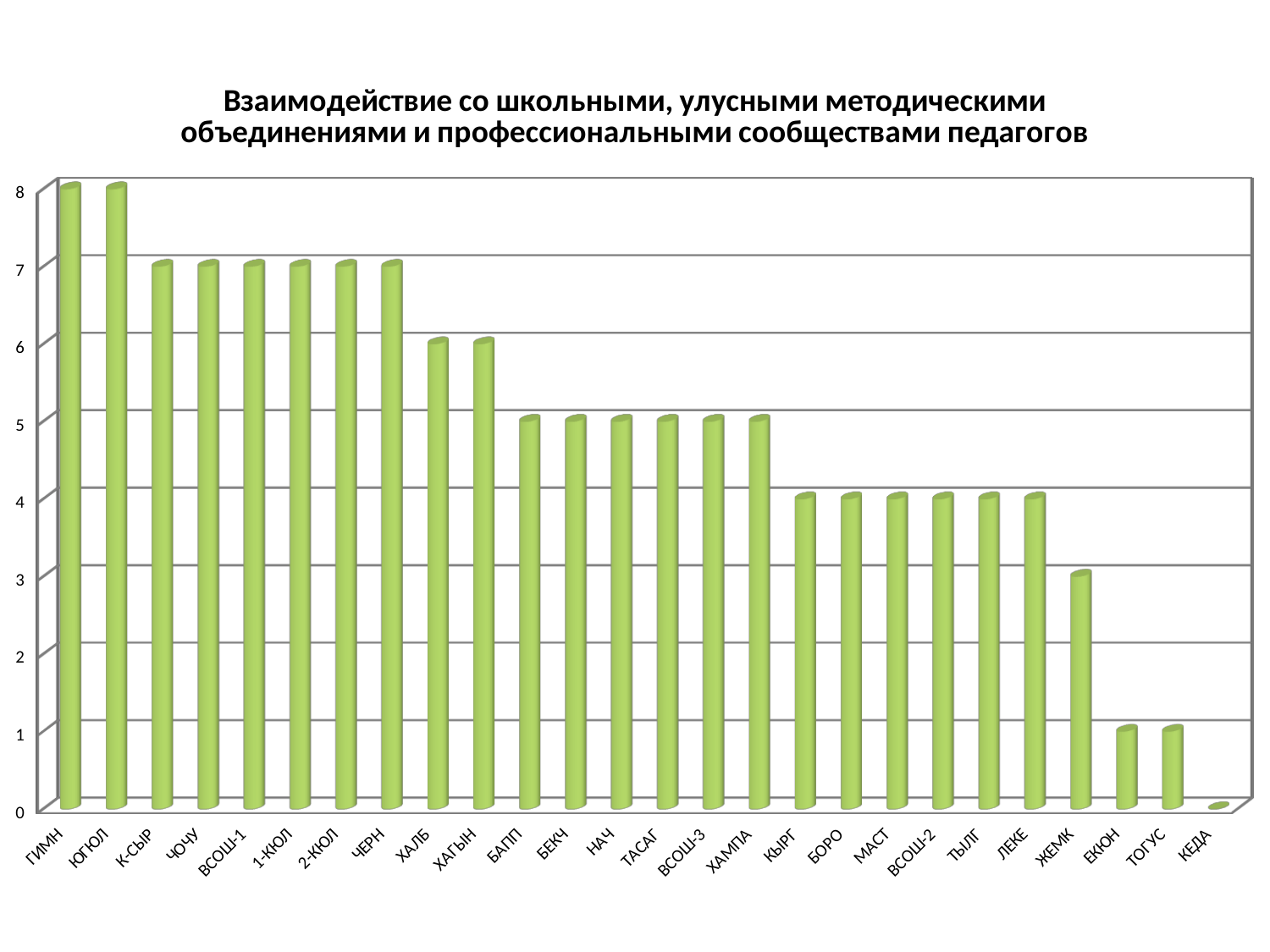
How many categories are shown on the x axis? 26 What is the value for ТОГУС? 1 What is the difference between the values for ЮГЮЛ and КЫРГ? 4 What is the value for ХАЛБ? 6 What is the title of the chart? Взаимодействие со школьными, улусными методическими объединениями и профессиональными сообществами педагогов Is the value for ХАГЫН greater or less than 5? greater Do the values rise or fall from left to right along the x axis? Fall What is the value for ЖЕМК? 3 Which is larger, the value for ЧЕРН or the value for БАПП? ЧЕРН What type of chart is shown on the slide? Bar chart What is the value for ГИМН? 8 Which category has the lowest value? КЕДА